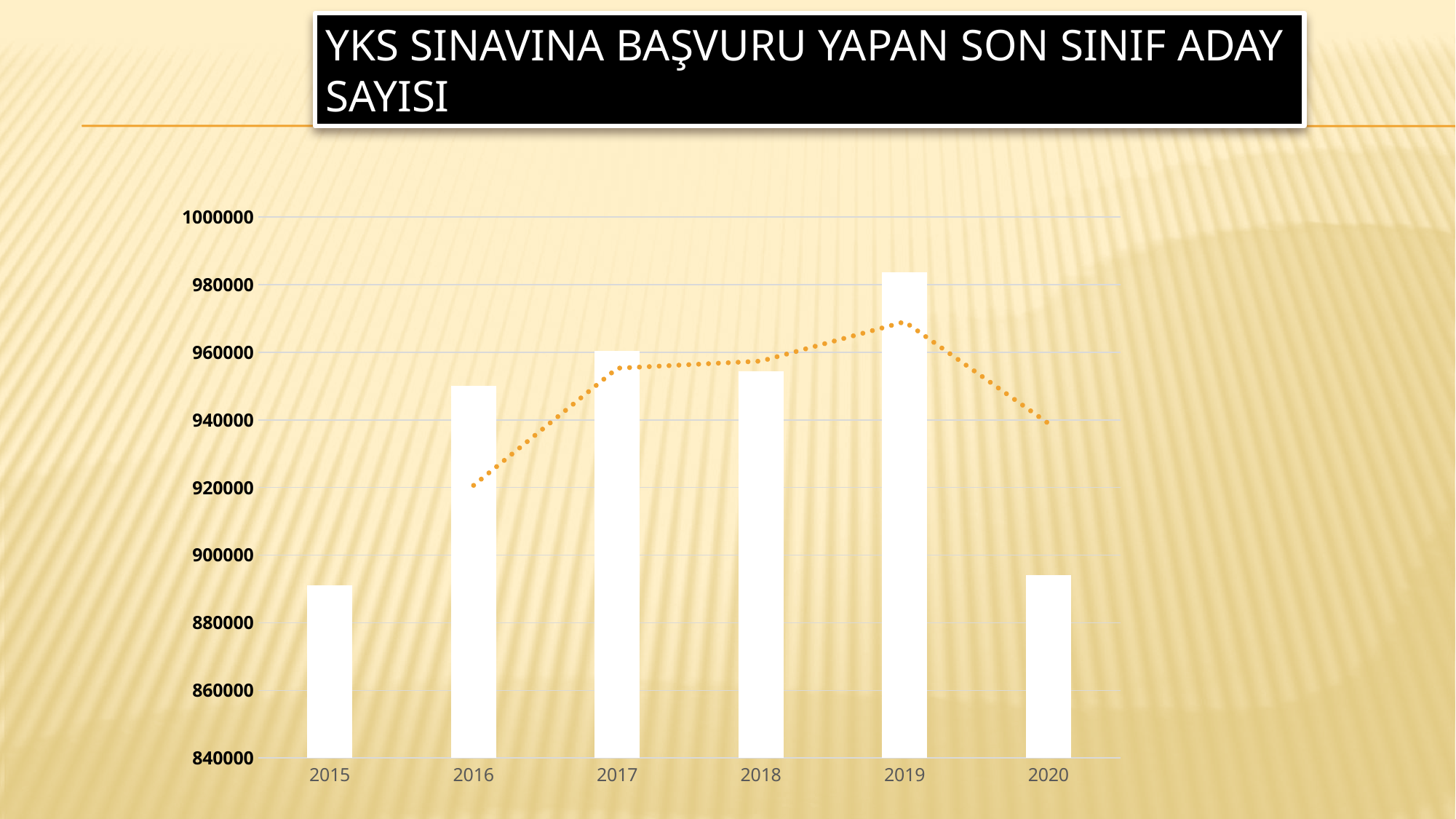
Is the value for 2019 greater or less than 980000? greater Which year has the highest number of applicants in the chart? 2019 Which is larger, the value for 2016 or the value for 2017? 2017 Do the values rise or fall from 2019 to 2020? fall What is the title of the chart on the slide? YKS SINAVINA BAŞVURU YAPAN SON SINIF ADAY SAYISI How many years are shown on the x axis of the chart? 6 Which is larger, the value for 2019 or the value for 2020? 2019 Is the value for 2018 greater or less than 960000? less Is the value for 2016 greater or less than 940000? greater What kind of chart is shown on the slide? bar chart